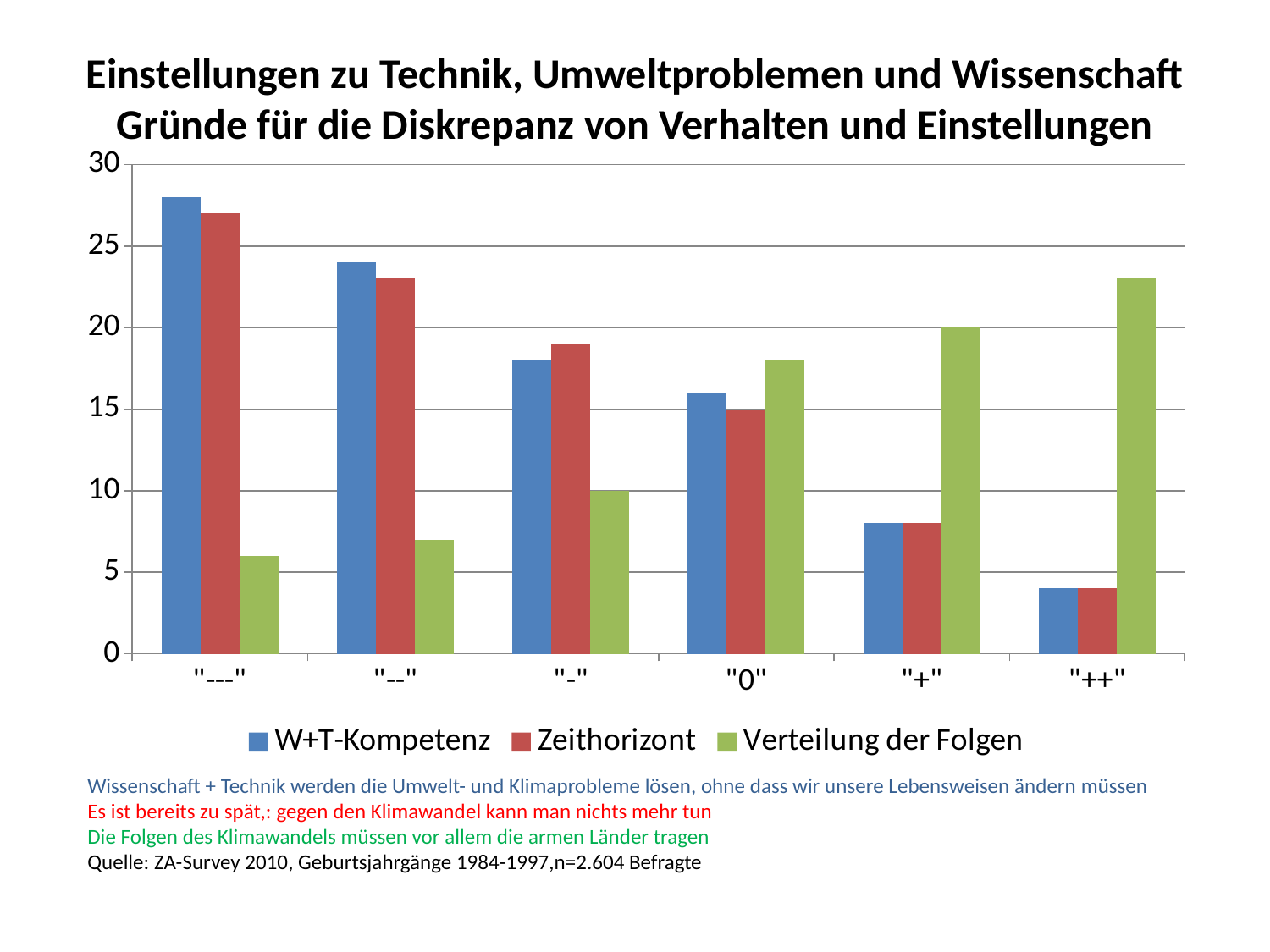
Is the value for Zeithorizont at "---" greater or less than 25? greater How many series does the legend list? 3 What kind of chart is shown on the slide? bar chart Which series is shown in green in the legend? Verteilung der Folgen At "0", which is larger: W+T-Kompetenz or Verteilung der Folgen? Verteilung der Folgen Do the values for W+T-Kompetenz rise or fall from "---" to "++"? fall How many categories are shown on the x axis? 6 Do the values for Verteilung der Folgen rise or fall from "---" to "++"? rise Which category has the lowest value for Verteilung der Folgen? "---" Is the value for Verteilung der Folgen at "--" greater or less than 10? less Which category has the highest value for W+T-Kompetenz? "---" Which category has the highest value for Verteilung der Folgen? "++"